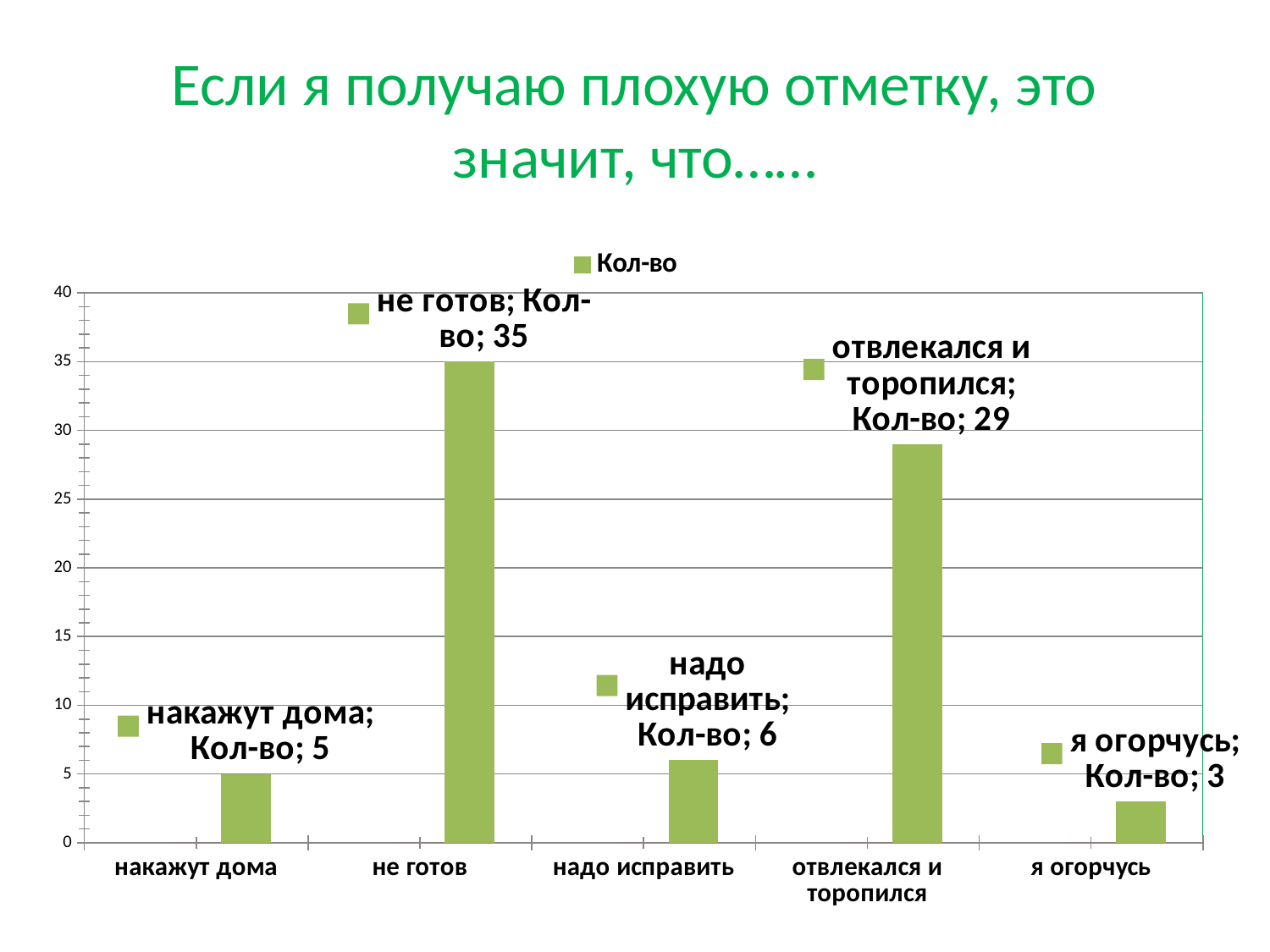
What is the value for "не готов"? 35 Which category has the lowest value? я огорчусь What is the difference between the values for "не готов" and "отвлекался и торопился"? 6 How many categories are shown on the x axis? 5 What is the value for "отвлекался и торопился"? 29 What is the name of the series shown in the legend? Кол-во What is the value for "я огорчусь"? 3 Which category has the highest value? не готов Which is larger, the value for "накажут дома" or the value for "надо исправить"? надо исправить What kind of chart is shown on the slide? bar chart How many series does the legend list? 1 Is the value for "отвлекался и торопился" greater or less than 25? greater